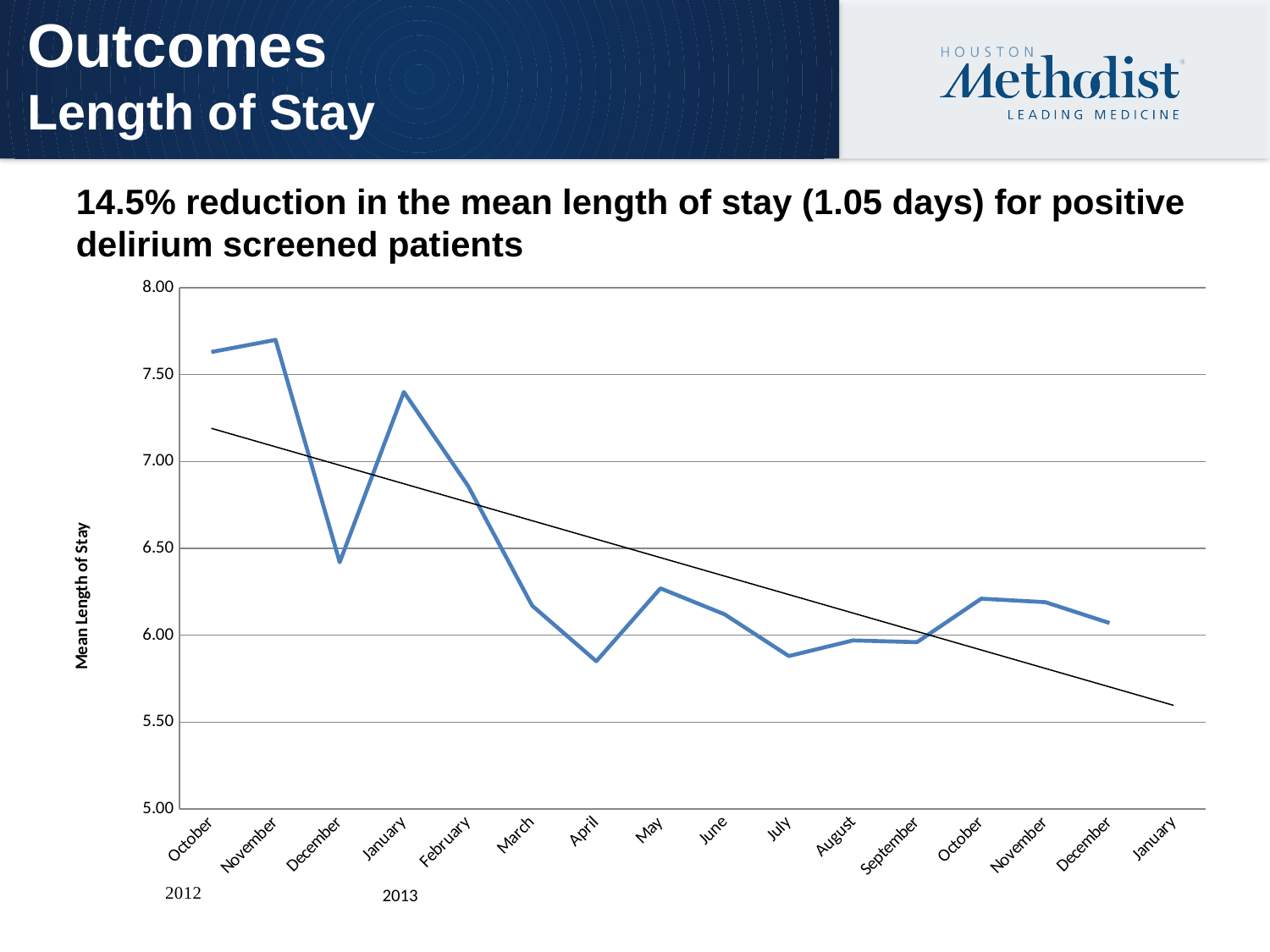
Is the value for January 2013 greater or less than 7.50? less Is the value for October 2012 greater or less than 7.50? greater Which month has the highest mean length of stay on the chart? November 2012 Is the value for April 2013 greater or less than 6.00? less Which is larger, the value for October 2012 or the value for December 2012? October 2012 How many month labels are shown along the x axis? 16 Which is larger, the value for February 2013 or the value for March 2013? February 2013 Overall, do the values of the blue line rise or fall from October 2012 to December 2013? fall What is the label on the y axis of the chart? Mean Length of Stay What kind of chart is shown on the slide? line chart